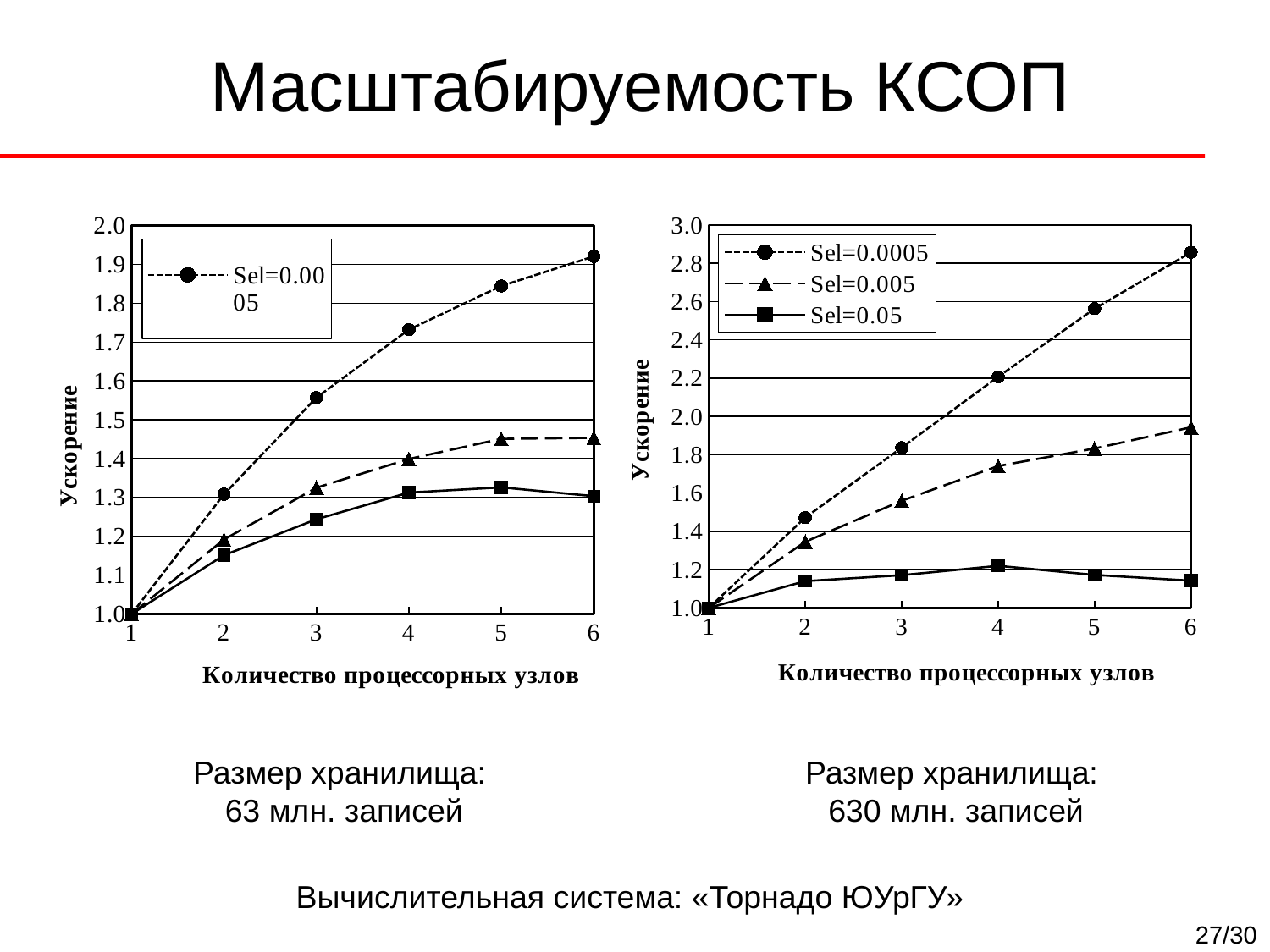
What is the x-axis title of the right chart (630 млн. записей)? Количество процессорных узлов In the left chart (63 млн. записей), is the value for Sel=0.0005 at 6 processor nodes greater or less than 1.8? greater What kind of chart is the left chart (63 млн. записей)? line chart In the right chart (630 млн. записей), how many processor-node values are plotted along the x axis? 6 In the right chart (630 млн. записей), is the value for Sel=0.05 at 4 processor nodes greater or less than 1.4? less In the left chart (63 млн. записей), what is the value of Sel=0.0005 at 1 processor node? 1.0 In the right chart (630 млн. записей), which series has the highest value at 6 processor nodes? Sel=0.0005 In the right chart (630 млн. записей), how many series does the legend list? 3 In the left chart (63 млн. записей), which is larger at 4 processor nodes: the value for Sel=0.0005 or the value for Sel=0.05? Sel=0.0005 In the right chart (630 млн. записей), does the Sel=0.0005 series rise or fall as the number of processor nodes increases? rises In the right chart (630 млн. записей), which series has the lowest value at 6 processor nodes? Sel=0.05 In the right chart (630 млн. записей), is the value for Sel=0.0005 at 6 processor nodes greater or less than 2.6? greater